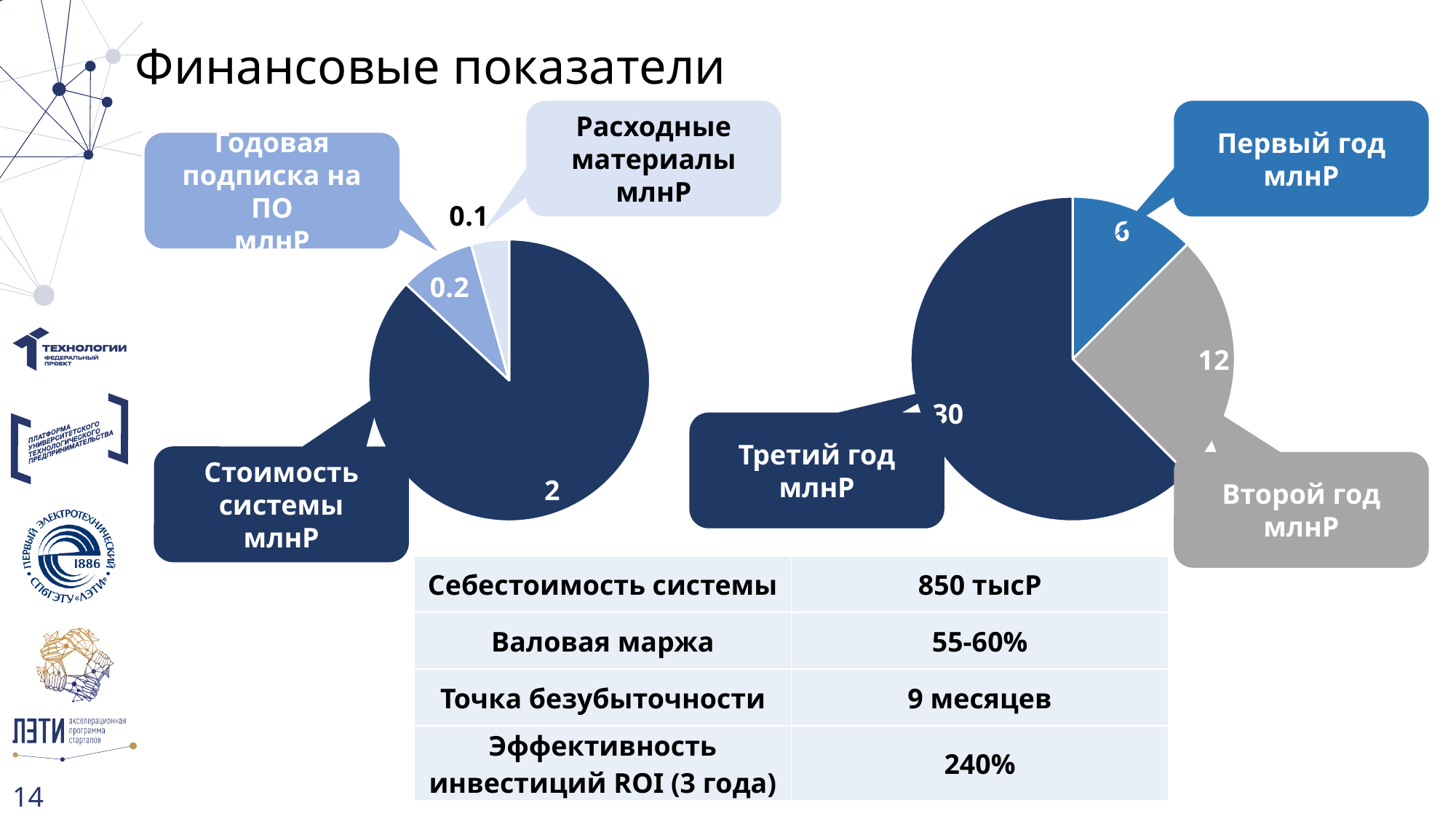
In the right pie chart, what is the value for Второй год? 12 In the left pie chart, which category has the smallest slice? Расходные материалы In the left pie chart, what is the value for Расходные материалы? 0.1 In the right pie chart, which is larger: Первый год or Второй год? Второй год In the left pie chart, what is the value for Годовая подписка на ПО? 0.2 In the left pie chart, which category has the largest slice? Стоимость системы In the right pie chart, what is the value for Третий год? 30 In the left pie chart, what is the value for Стоимость системы? 2 In the right pie chart, what is the value for Первый год? 6 How many slices does the left pie chart have? 3 What kind of chart is the left chart on the slide? pie chart In the right pie chart, what is the difference between the values for Третий год and Второй год? 18